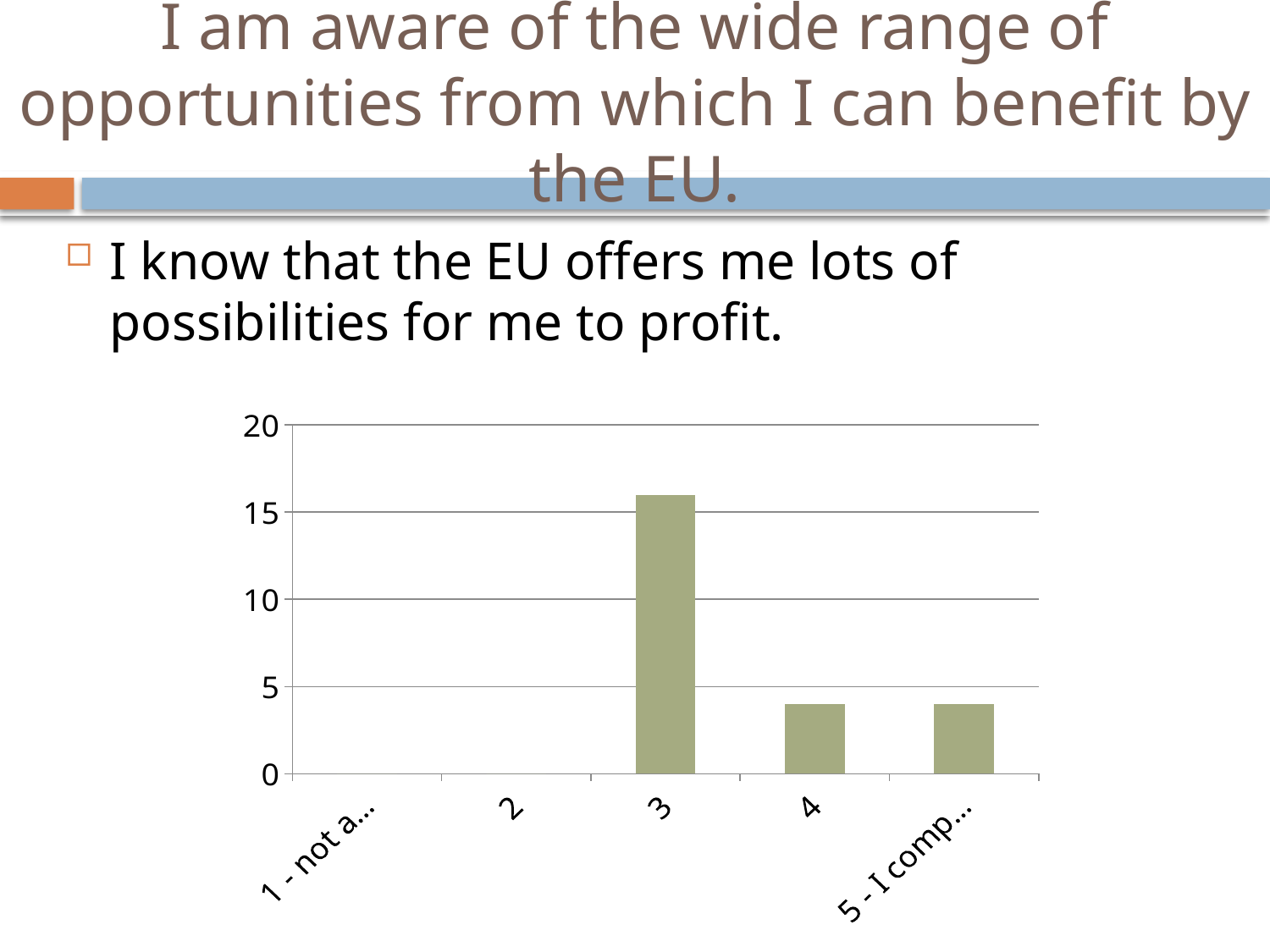
What is the value shown for category 2 in the chart? 0 Is the value for category 4 greater or less than 5? less Is the value for category 3 greater or less than 20? less Is the value for category 3 greater or less than 15? greater Which category has the highest bar in the chart? 3 What is the highest value labelled on the vertical axis of the chart? 20 Which is larger, the value for category 3 or the value for category 4? 3 What kind of chart is shown on the slide? bar chart How many categories are shown on the x axis of the chart? 5 What colour are the bars in the chart? olive green